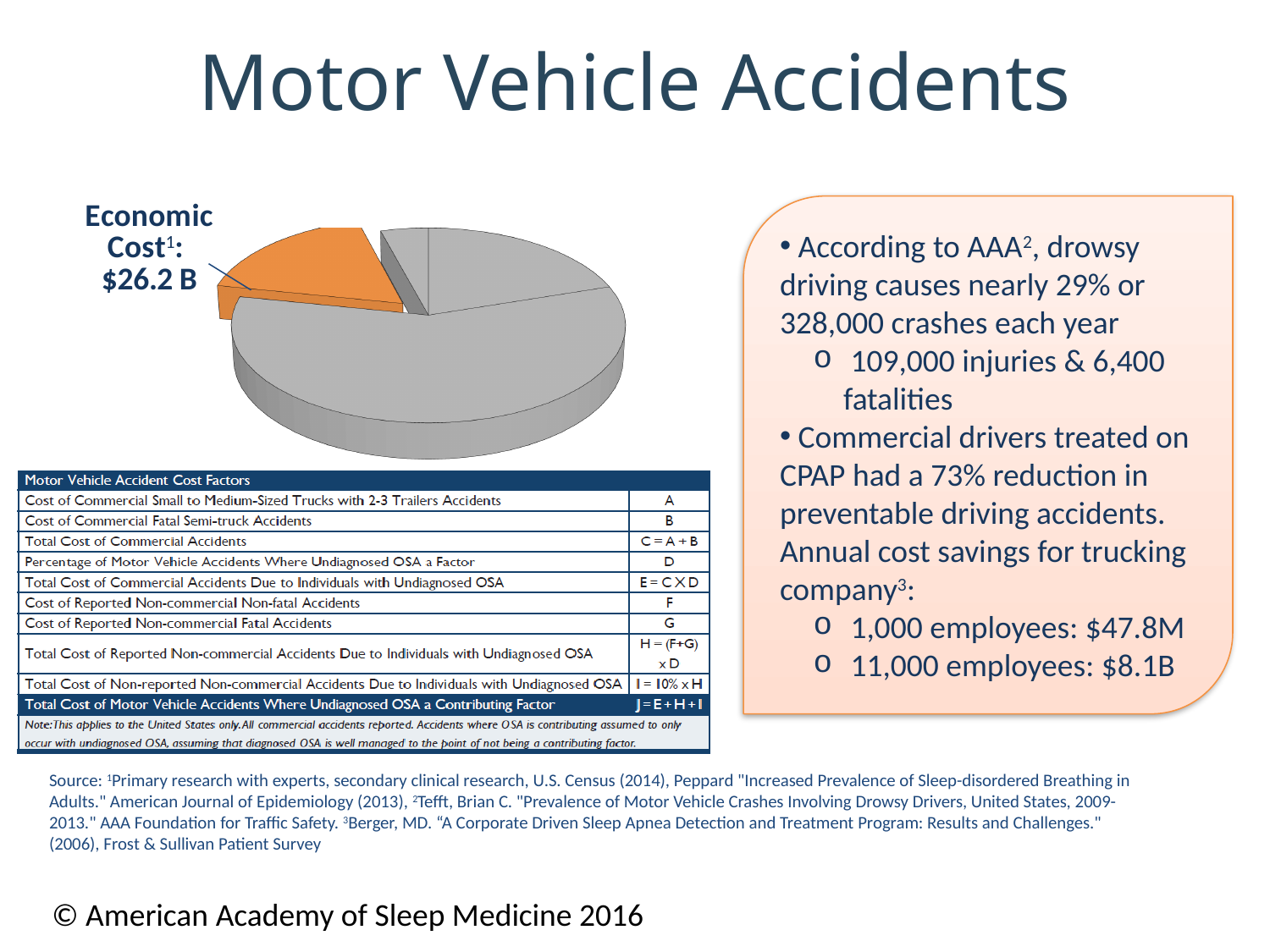
What kind of chart is shown on the slide? Pie chart What value is labelled on the highlighted (exploded) slice of the pie chart? $26.2 B Which slice of the pie chart is the largest? The large gray slice What colour is the exploded slice of the pie chart? Orange Is the orange Economic Cost slice larger or smaller than the large gray slice of the pie chart? Smaller How many slices does the pie chart have? 4 What does the label on the exploded slice of the pie chart represent? Economic Cost